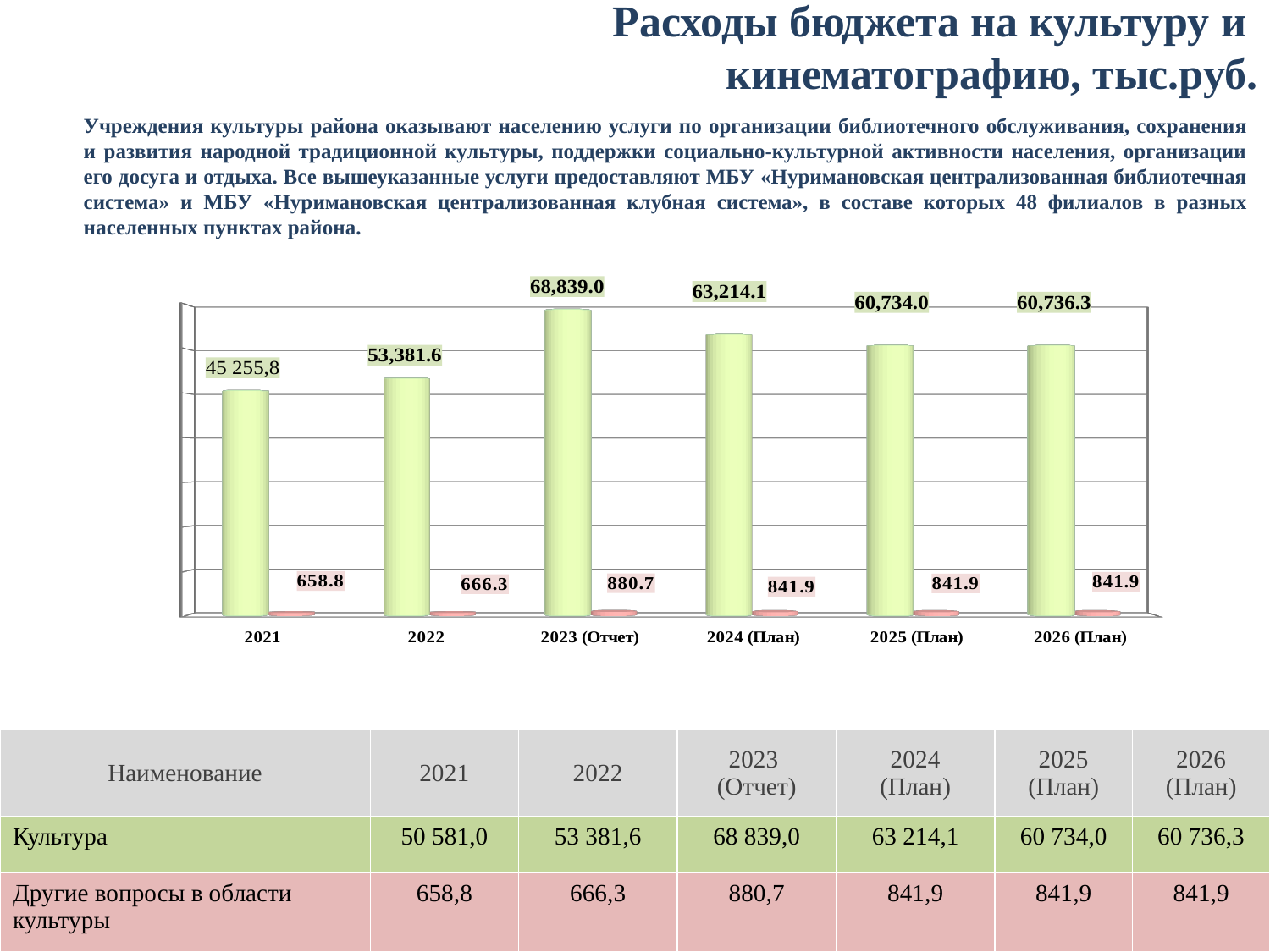
What is the value of the small pink bar for 2021? 658.8 What is the value of the tall green bar for 2024 (План)? 63,214.1 In which year is the tall green bar the highest? 2023 (Отчет) What kind of chart is shown on the slide? bar chart What is the difference between the green bar values for 2023 (Отчет) and 2024 (План)? 5,624.9 How many year categories are shown along the x axis of the chart? 6 What is the difference between the pink bar values for 2023 (Отчет) and 2024 (План)? 38.8 What is the value of the small pink bar for 2023 (Отчет)? 880.7 What is the value of the tall green bar for 2023 (Отчет)? 68,839.0 In which year is the small pink bar the lowest? 2021 Do the green bar values rise or fall from 2021 to 2023 (Отчет)? rise Which is larger, the green bar for 2022 or the green bar for 2024 (План)? 2024 (План)